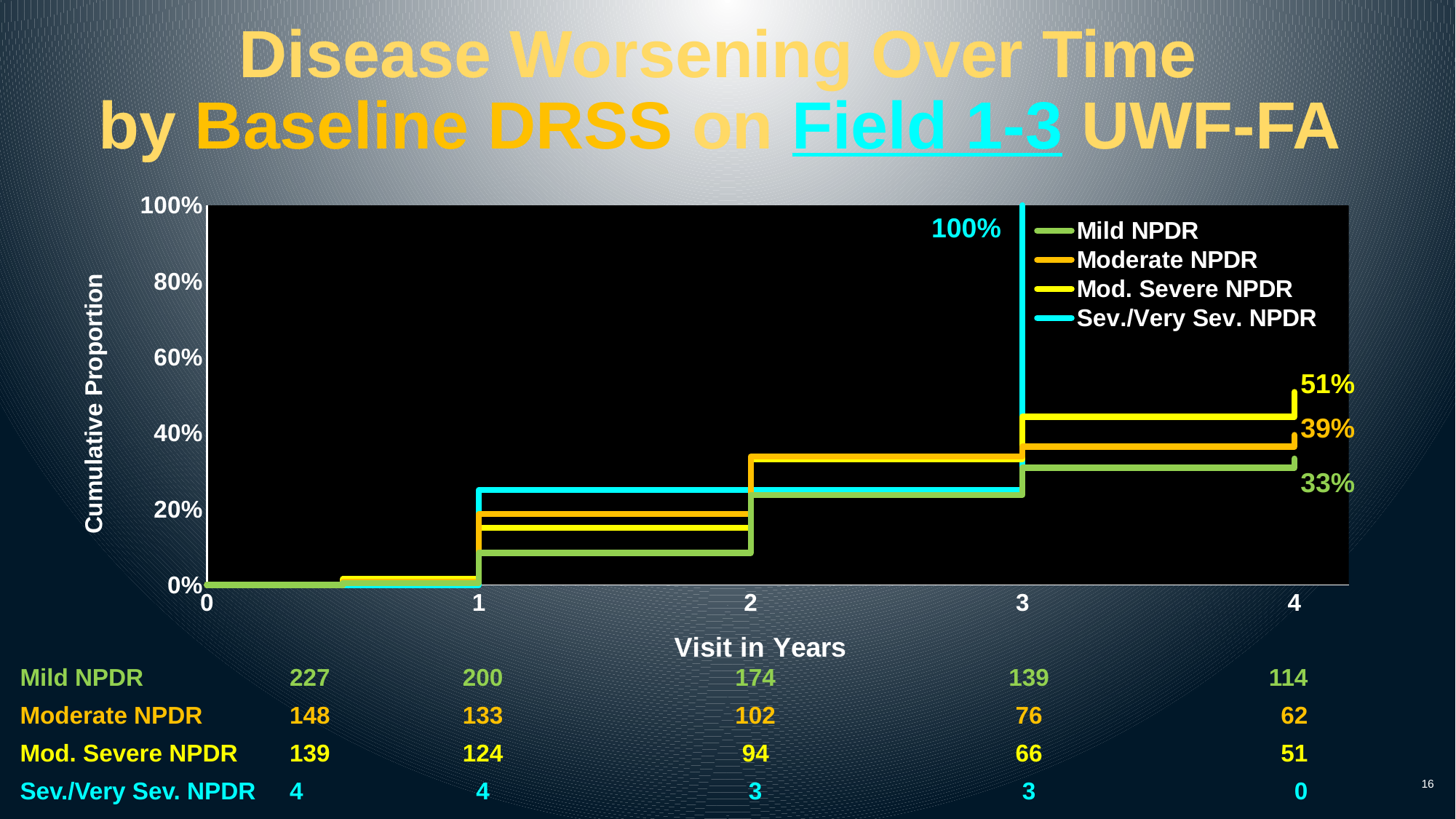
What is the cumulative proportion labelled for Mod. Severe NPDR at year 4? 51% Among the series labelled at year 4, which has the lowest cumulative proportion? Mild NPDR What is the difference between the year-4 labels for Mod. Severe NPDR and Mild NPDR? 18 percentage points Is the value for Sev./Very Sev. NPDR at year 1 greater or less than 20%? greater What kind of chart is shown? Line chart (step curves) What is the cumulative proportion labelled for Mild NPDR at year 4? 33% At year 4, which is larger: the Moderate NPDR value or the Mod. Severe NPDR value? Mod. Severe NPDR Which series reaches the 100% label on the chart? Sev./Very Sev. NPDR What is the cumulative proportion labelled for Moderate NPDR at year 4? 39% Is the value for Mod. Severe NPDR at year 1 greater or less than 20%? less Do the cumulative proportions rise or fall as the visit year increases? Rise How many series does the legend list? 4